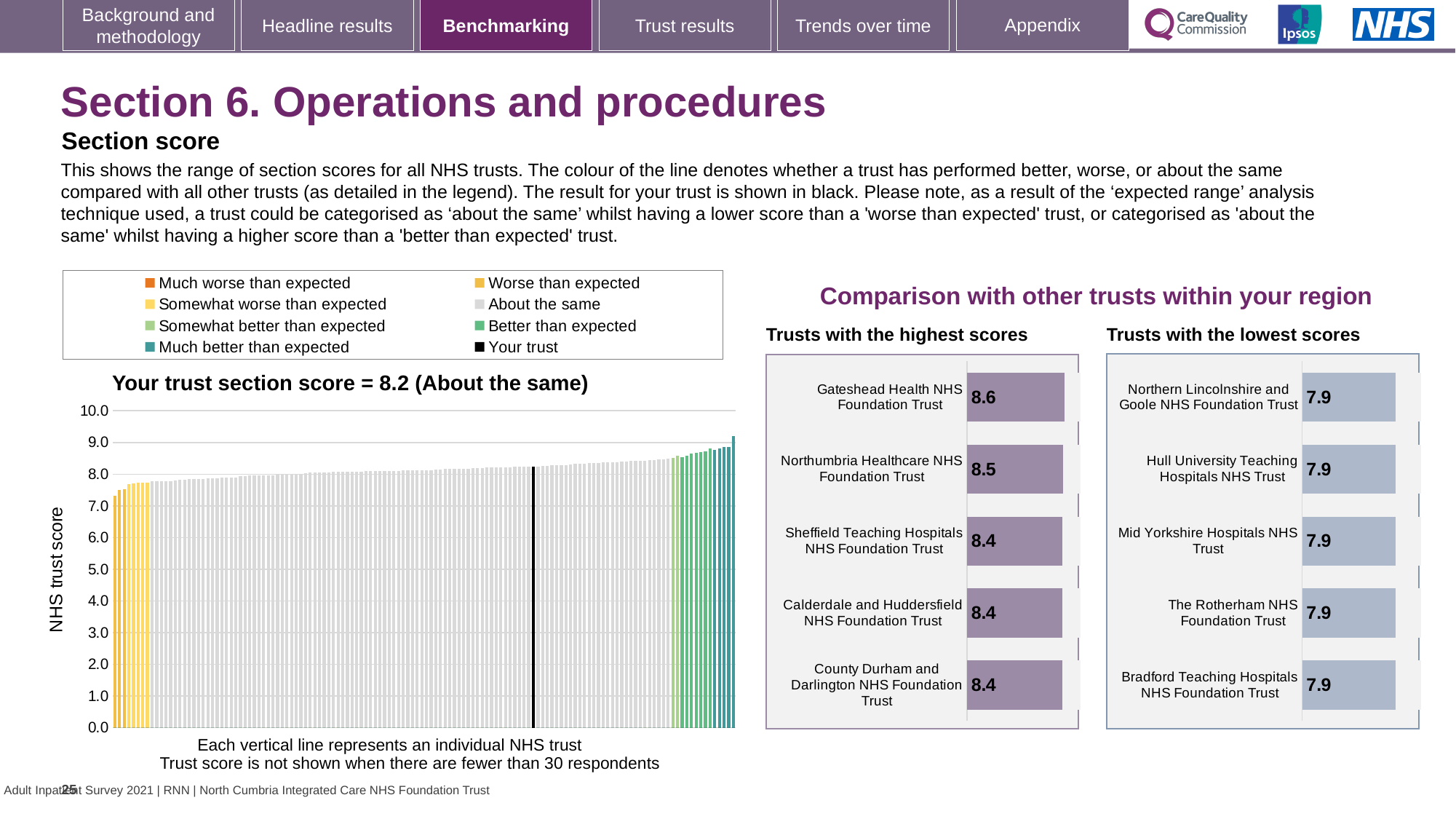
In the 'Your trust section score' chart, what is the section score for your trust? 8.2 How many trusts are shown in the 'Trusts with the lowest scores' chart? 5 In the 'Trusts with the highest scores' chart, what is the difference between the scores of Gateshead Health NHS Foundation Trust and Northumbria Healthcare NHS Foundation Trust? 0.1 In the 'Trusts with the highest scores' chart, what is the score for Gateshead Health NHS Foundation Trust? 8.6 In the 'Your trust section score' chart, do the bar heights rise or fall from left to right? rise In the 'Your trust section score' chart, which category is your trust placed in? About the same In the 'Trusts with the highest scores' chart, which trust has the highest score? Gateshead Health NHS Foundation Trust What kind of chart is the 'Your trust section score' chart? bar chart In the 'Your trust section score' chart, is the value of the lowest bar greater or less than 8.0? less In the 'Trusts with the lowest scores' chart, what is the score for Mid Yorkshire Hospitals NHS Trust? 7.9 How many entries does the legend above the 'Your trust section score' chart list? 8 What is the label on the vertical axis of the 'Your trust section score' chart? NHS trust score